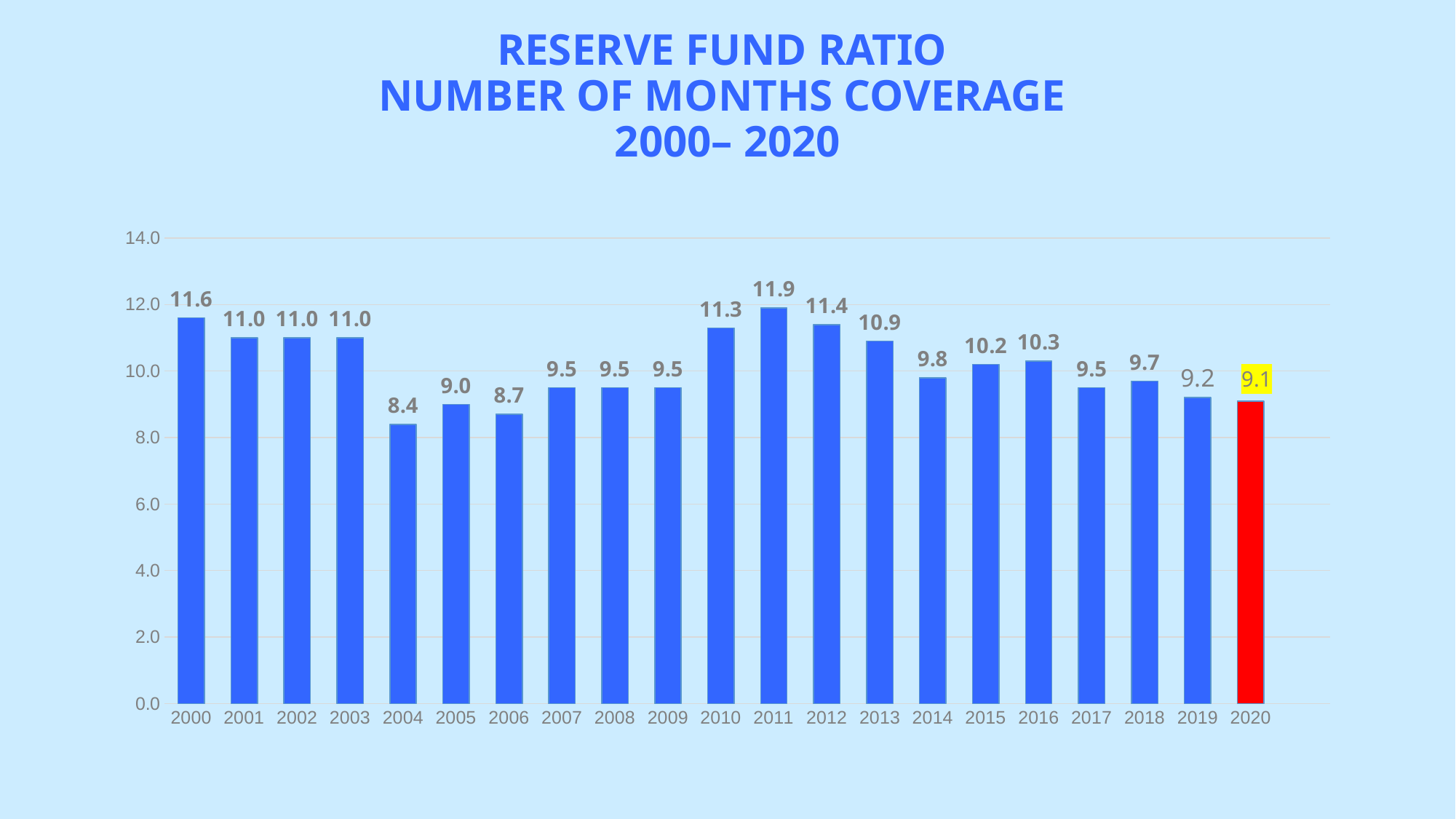
What is the difference between the reserve fund ratio in 2000 and in 2020? 2.5 What is the reserve fund ratio for 2004? 8.4 What is the reserve fund ratio for 2011? 11.9 Did the reserve fund ratio rise or fall from 2016 to 2020? Fall Which year has a higher reserve fund ratio, 2016 or 2019? 2016 What is the difference between the reserve fund ratio in 2011 and in 2004? 3.5 How many years are shown on the chart? 21 Which year has the lowest reserve fund ratio? 2004 What kind of chart is shown on the slide? Bar chart What is the reserve fund ratio (number of months coverage) for 2020? 9.1 Which year's bar is coloured red instead of blue? 2020 Which year has the highest reserve fund ratio? 2011